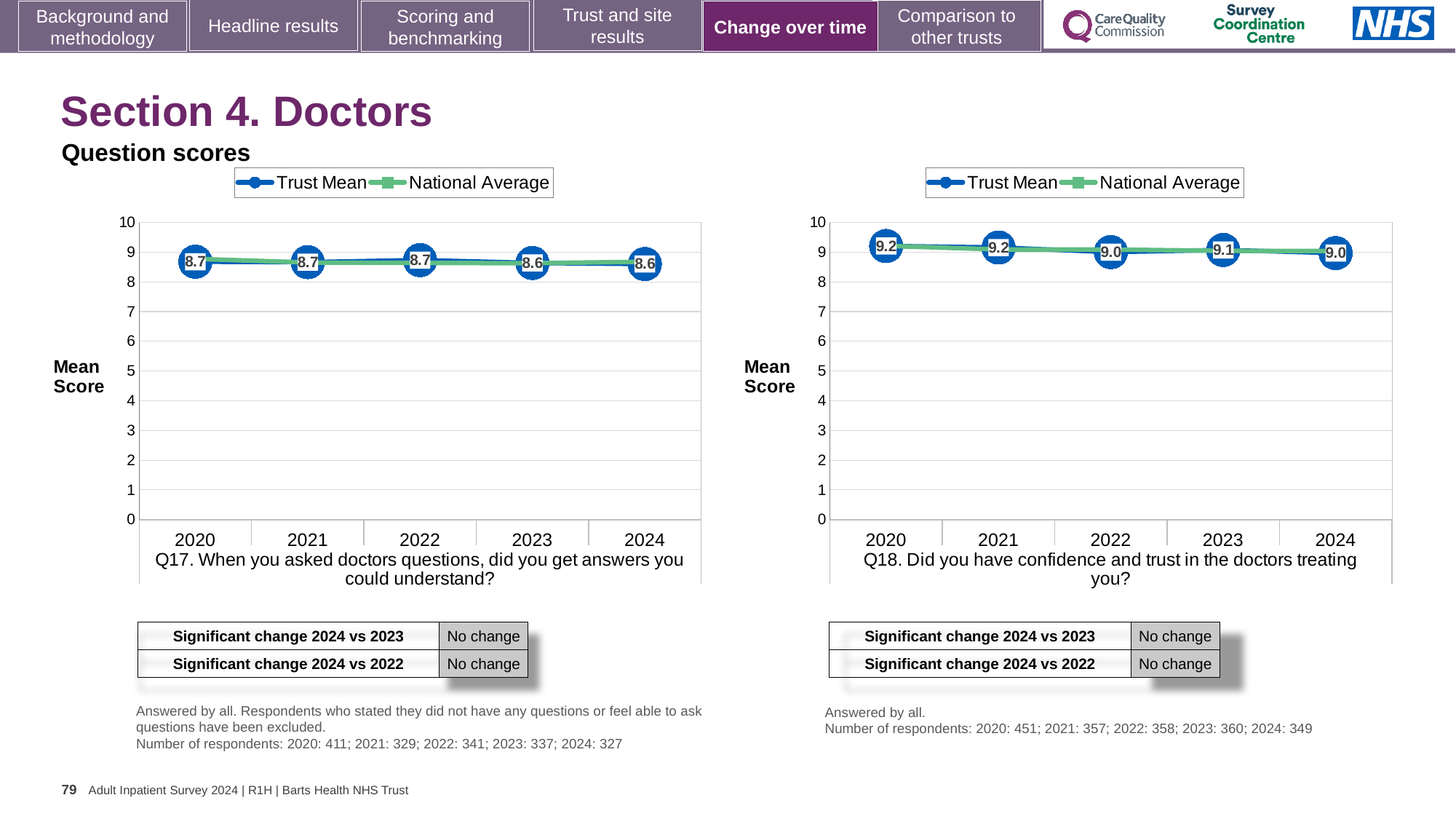
In the Q18 chart, what is the Trust Mean score for 2023? 9.1 In the Q18 chart, is the Trust Mean score for 2020 greater or less than 9? greater In the Q17 chart, what is the difference between the Trust Mean score in 2022 and in 2023? 0.1 In the Q17 chart, what is the Trust Mean score for 2020? 8.7 What is the label of the y axis on the Q17 chart? Mean Score What type of chart is used for Q17? Line chart In the Q18 chart, what is the Trust Mean score for 2022? 9.0 How many years are shown on the x axis of the Q17 chart? 5 In the Q18 chart, what is the difference between the Trust Mean score in 2020 and in 2024? 0.2 In the Q18 chart, is the Trust Mean score higher in 2021 or in 2022? 2021 In the Q17 chart, what is the Trust Mean score for 2024? 8.6 How many series does the legend of the Q18 chart list? 2